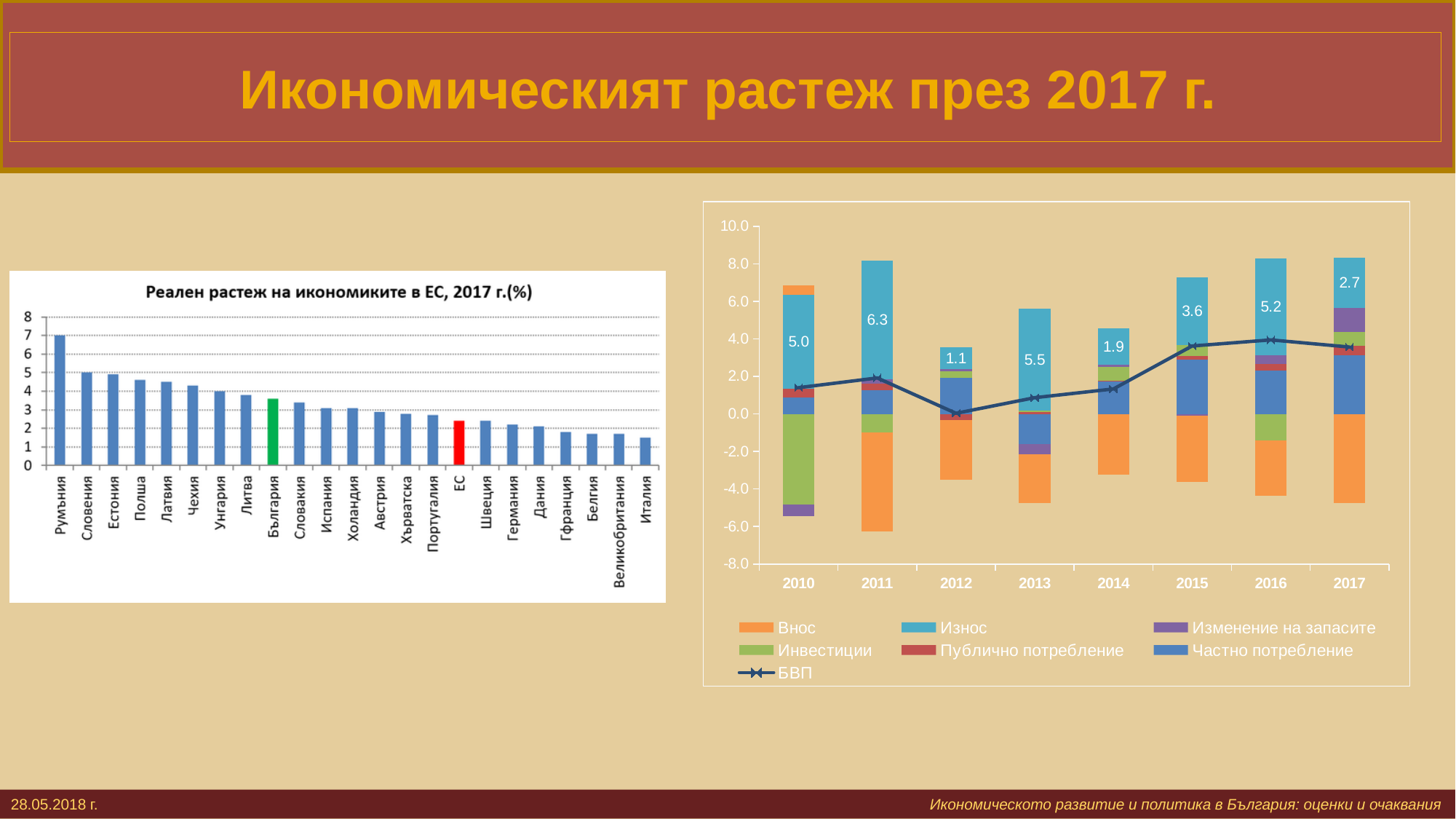
In the right stacked bar chart, what is the difference between the labelled Износ values for 2011 and 2012? 5.2 In the right stacked bar chart, what is the labelled value of Износ for 2011? 6.3 In the right stacked bar chart, is the БВП line value for 2016 greater or less than 2.0? greater In the left chart "Реален растеж на икономиките в ЕС, 2017 г.(%)", which country has the highest bar? Румъния How many series does the legend of the right chart list? 7 What kind of chart is the left chart titled "Реален растеж на икономиките в ЕС, 2017 г.(%)"? bar chart In the left chart "Реален растеж на икономиките в ЕС, 2017 г.(%)", which bar is coloured green? България In the right stacked bar chart, what is the labelled value of Износ for 2017? 2.7 In the left chart "Реален растеж на икономиките в ЕС, 2017 г.(%)", which country has the lowest bar? Италия In the left chart "Реален растеж на икономиките в ЕС, 2017 г.(%)", is the value for България greater or less than 3? greater In the left chart "Реален растеж на икономиките в ЕС, 2017 г.(%)", is the value for Румъния greater or less than 6? greater In the right stacked bar chart, which year has the lowest labelled Износ value? 2012